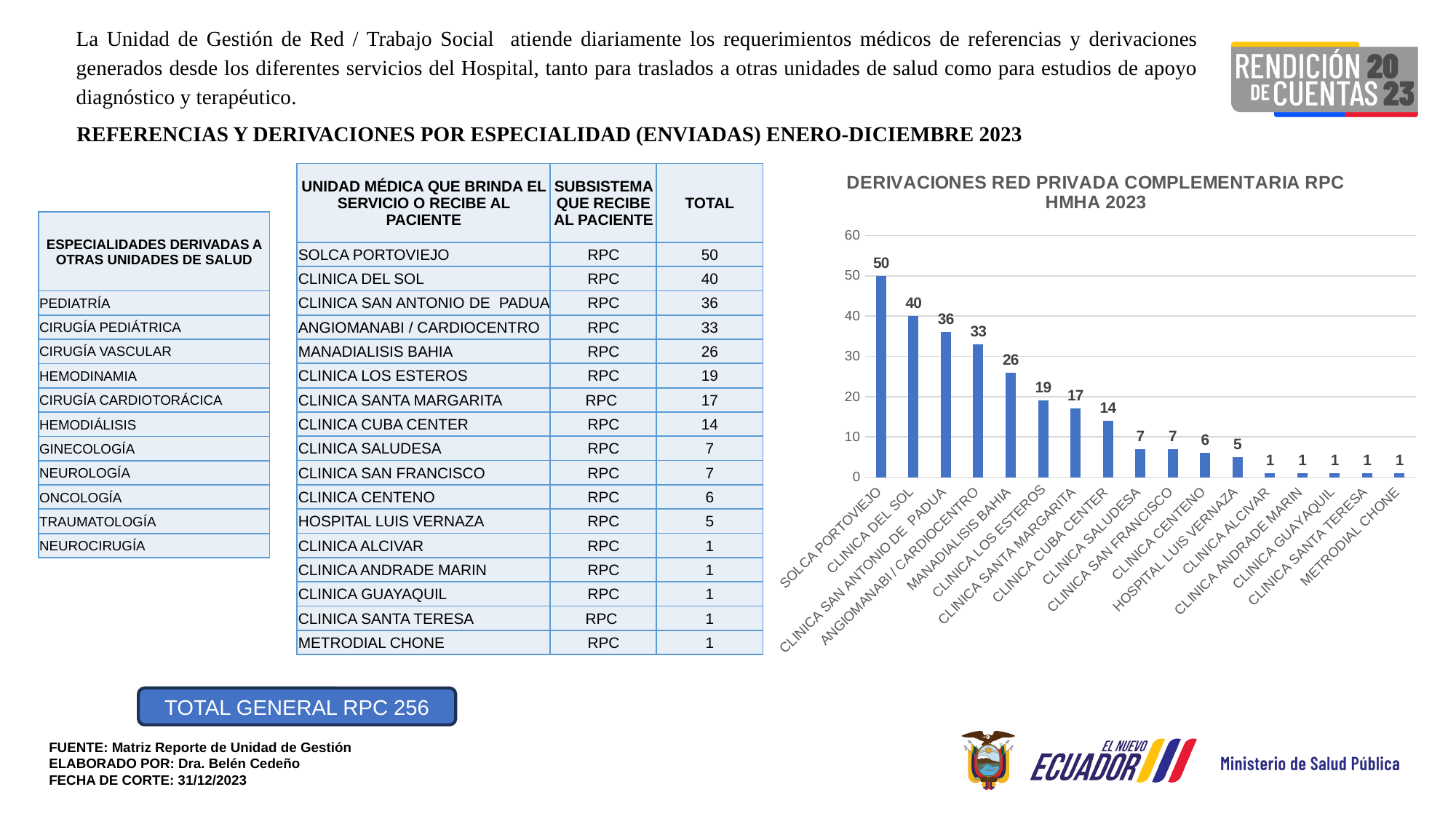
What is the title of the chart? DERIVACIONES RED PRIVADA COMPLEMENTARIA RPC HMHA 2023 What is the difference between the values for CLINICA DEL SOL and CLINICA SAN ANTONIO DE PADUA? 4 What is the value for SOLCA PORTOVIEJO in the chart? 50 What is the value for ANGIOMANABI / CARDIOCENTRO in the chart? 33 What is the value for HOSPITAL LUIS VERNAZA in the chart? 5 What kind of chart is shown on the slide? bar chart How many categories in the chart have a value of 1? 5 Which category has the highest value in the chart? SOLCA PORTOVIEJO What is the value for CLINICA CUBA CENTER in the chart? 14 Which is larger, the value for MANADIALISIS BAHIA or the value for CLINICA LOS ESTEROS? MANADIALISIS BAHIA Do the values rise or fall from left to right along the x axis? fall How many categories are shown on the x axis of the chart? 17